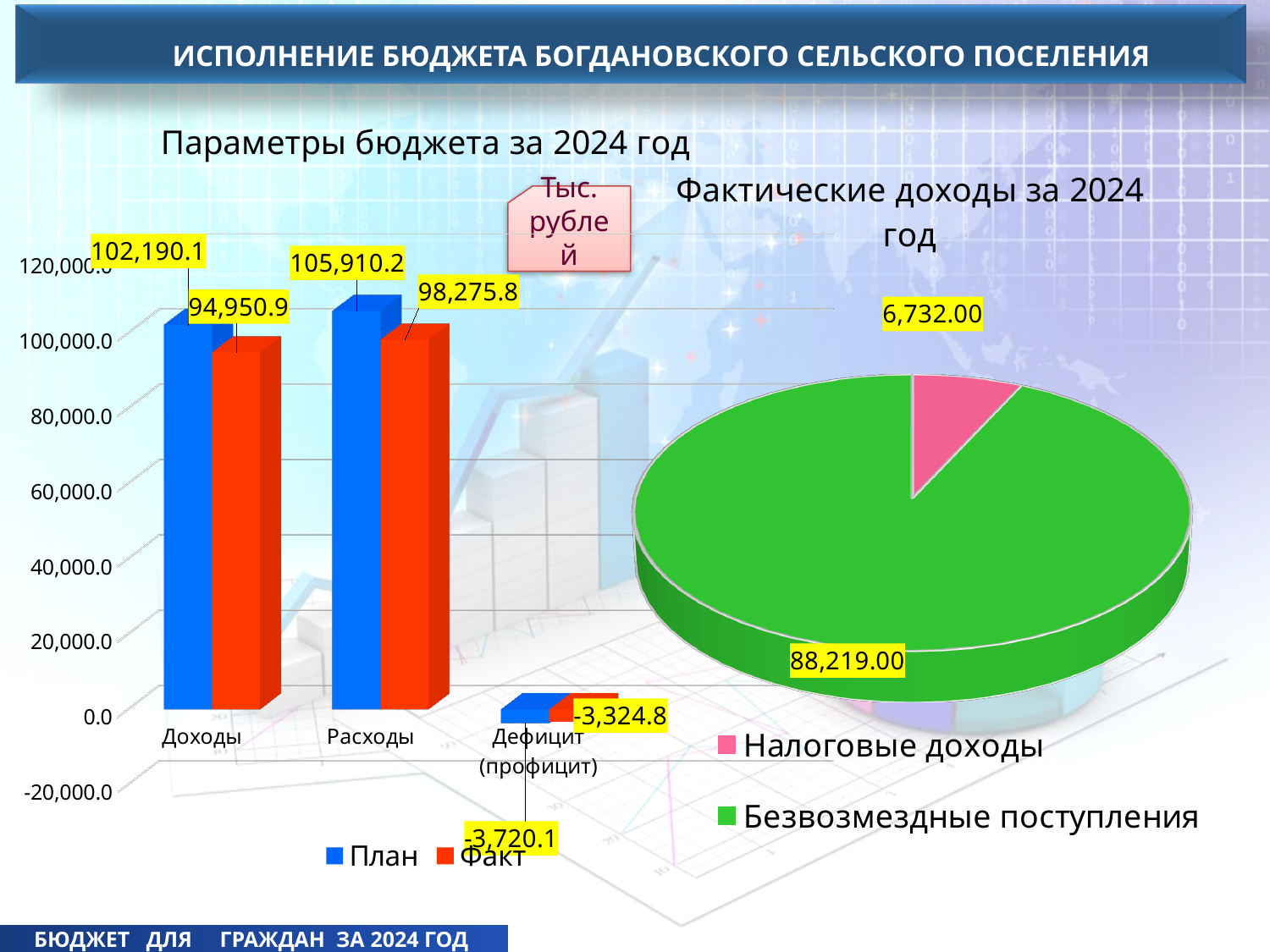
In the chart 'Параметры бюджета за 2024 год', what is the Факт value for Дефицит (профицит)? -3,324.8 In the chart 'Параметры бюджета за 2024 год', which category has the highest План value? Расходы In the chart 'Параметры бюджета за 2024 год', how many series does the legend list? 2 In the chart 'Параметры бюджета за 2024 год', what is the difference between the План and Факт values for Доходы? 7,239.2 What kind of chart is 'Фактические доходы за 2024 год'? Pie chart In the chart 'Параметры бюджета за 2024 год', how many categories are shown on the x axis? 3 In the chart 'Параметры бюджета за 2024 год', what is the Факт value for Расходы? 98,275.8 In the chart 'Параметры бюджета за 2024 год', which is larger for Расходы: План or Факт? План In the chart 'Фактические доходы за 2024 год', what is the value for Безвозмездные поступления? 88,219.00 In the chart 'Фактические доходы за 2024 год', which slice is the smallest? Налоговые доходы In the chart 'Параметры бюджета за 2024 год', what is the План value for Доходы? 102,190.1 In the chart 'Фактические доходы за 2024 год', what colour is the Налоговые доходы slice? Pink